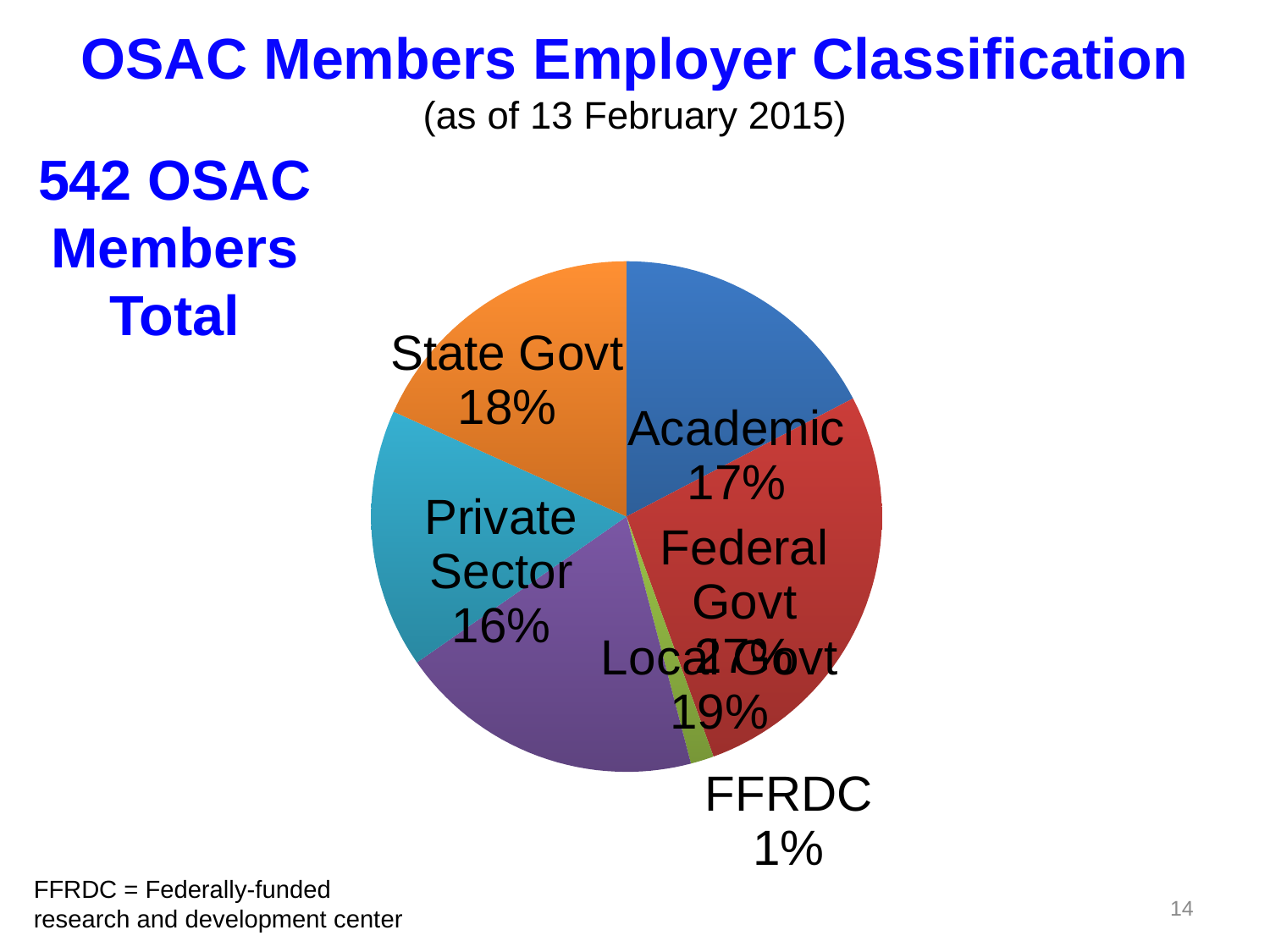
What share of OSAC members are classified as Local Govt? 19% How many employer classifications are shown in the pie chart? 6 What kind of chart is shown on the slide? pie chart What share of OSAC members are classified as FFRDC? 1% Which employer classification has the largest slice of the pie? Federal Govt What is the difference in percentage points between the Local Govt share and the Private Sector share? 3 What share of OSAC members are classified as Private Sector? 16% Which is larger, the State Govt share or the Private Sector share? State Govt Which employer classification has the smallest slice of the pie? FFRDC According to the slide, how many OSAC members are there in total? 542